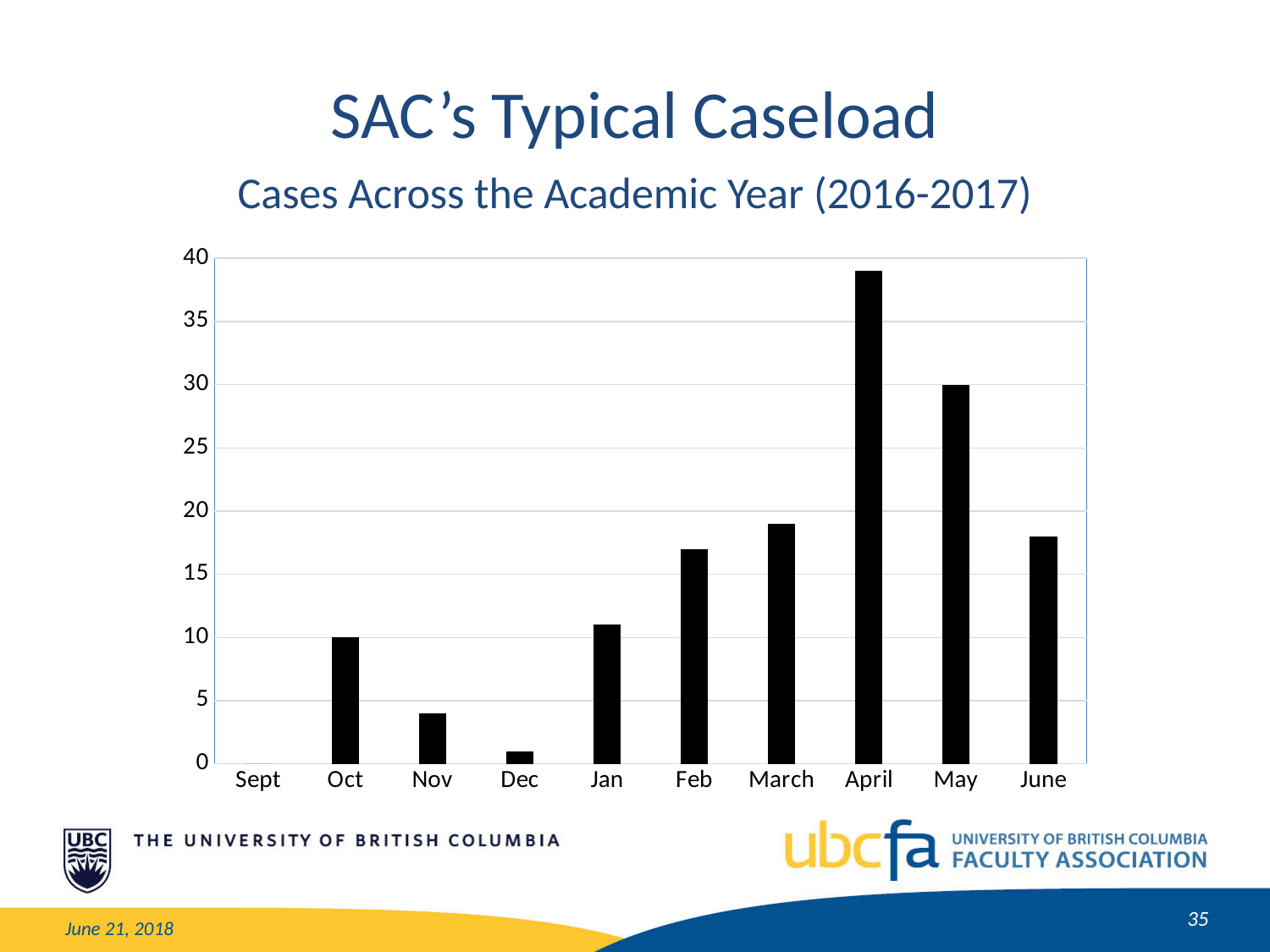
Is the value for Feb greater or less than 15? greater Is the value for Dec greater or less than 5? less What kind of chart is shown on the slide? bar chart Which is larger, the value for April or the value for May? April Which month has the lowest number of cases? Sept How many months are shown on the x axis of the chart? 10 Is the value for Nov greater or less than 5? less What is the value for May? 30 What is the value for Oct? 10 Which month has the highest number of cases? April What is the subtitle of the chart on the slide? Cases Across the Academic Year (2016-2017)